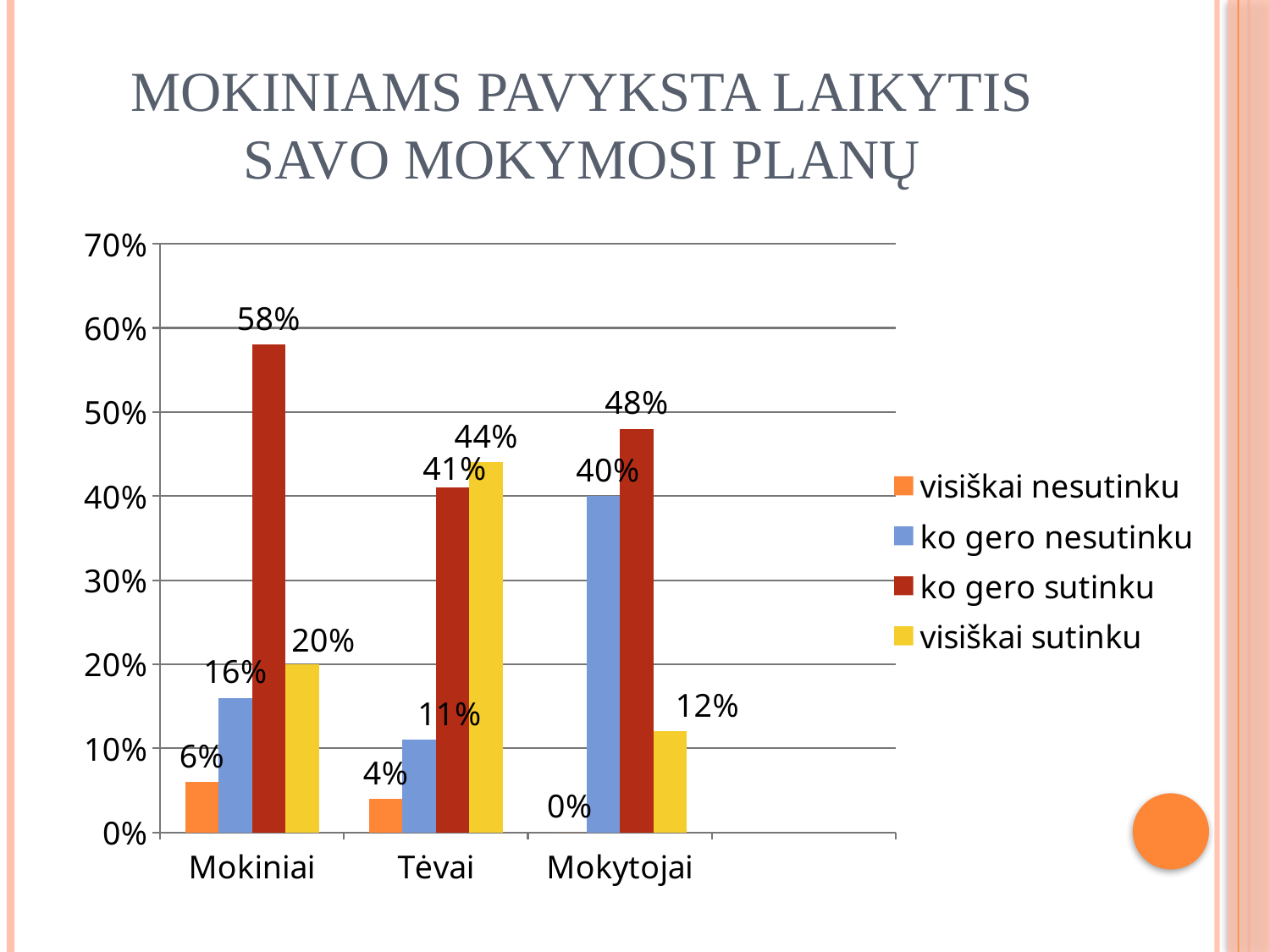
Which category has the lowest value for "visiškai sutinku"? Mokytojai How many categories are shown on the x axis? 3 Which category has the highest value for "ko gero sutinku"? Mokiniai How many series does the legend list? 4 What is the difference between the "ko gero sutinku" values for Mokiniai and Mokytojai? 10% What is the value for "visiškai sutinku" in the Tėvai category? 44% Which is larger: "ko gero nesutinku" for Mokiniai or "ko gero nesutinku" for Mokytojai? Mokytojai What is the value for "ko gero sutinku" in the Mokiniai category? 58% Which colour represents the "visiškai sutinku" series? Yellow What is the value for "visiškai nesutinku" in the Mokytojai category? 0% What is the value for "ko gero nesutinku" in the Mokytojai category? 40% What kind of chart is shown on the slide? Bar chart